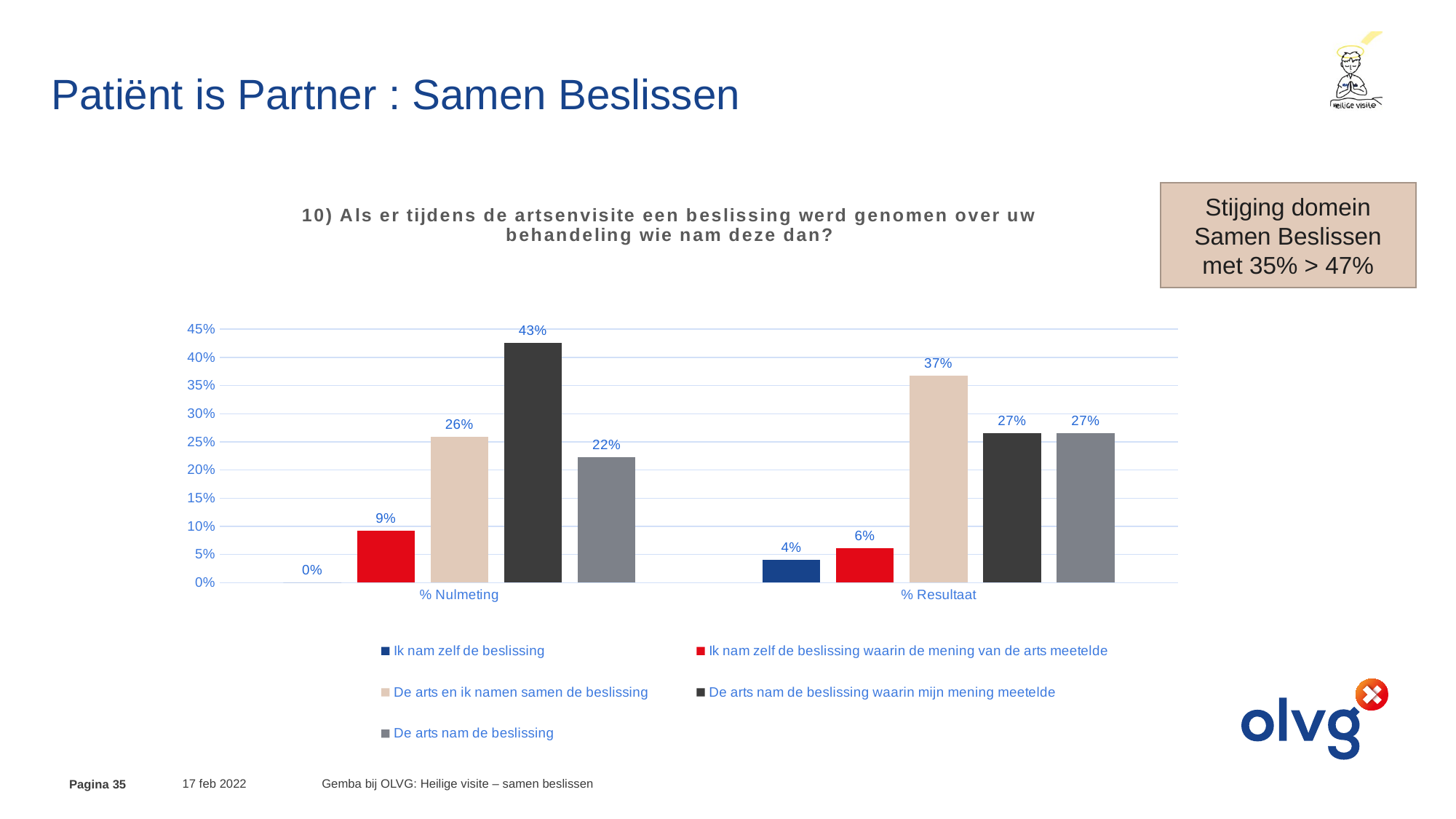
Which series has the highest value in the % Resultaat group? De arts en ik namen samen de beslissing What is the value for "De arts nam de beslissing waarin mijn mening meetelde" in the % Nulmeting group? 43% What is the value for "Ik nam zelf de beslissing" in the % Nulmeting group? 0% What is the value for "De arts en ik namen samen de beslissing" in the % Resultaat group? 37% What colour are the bars for "De arts en ik namen samen de beslissing"? Beige What is the value for "Ik nam zelf de beslissing waarin de mening van de arts meetelde" in the % Resultaat group? 6% What is the difference between the % Nulmeting and % Resultaat values for "De arts nam de beslissing waarin mijn mening meetelde"? 16% Which is larger: the % Nulmeting value or the % Resultaat value for "De arts en ik namen samen de beslissing"? % Resultaat How many series does the legend list? 5 Which series has the lowest value in the % Nulmeting group? Ik nam zelf de beslissing What kind of chart is shown on the slide? Bar chart How many category groups are shown on the x axis? 2